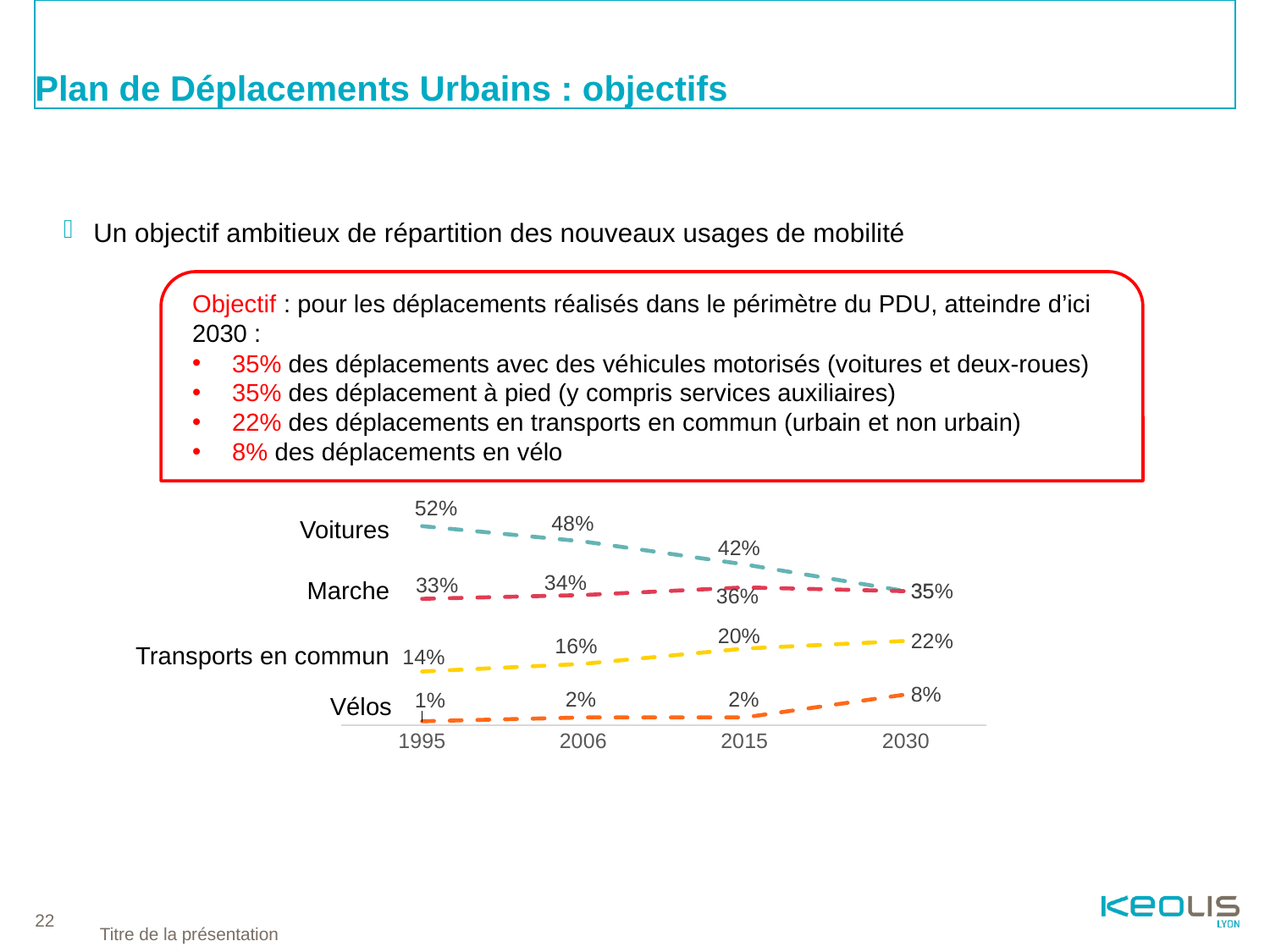
What is the value for Marche in 2006? 34% What is the value for Transports en commun in 2015? 20% What is the difference between the Voitures values in 1995 and 2015? 10% What kind of chart is shown on the slide? line chart Which series has the highest value in 1995? Voitures What is the value for Voitures in 1995? 52% Which series has the lowest value in 2015? Vélos What is the value for Vélos in 2030? 8% How many series are plotted in the chart? 4 Which is larger in 2006: Transports en commun or Marche? Marche Does the Voitures series rise or fall from 1995 to 2030? fall How many years are shown on the x axis? 4